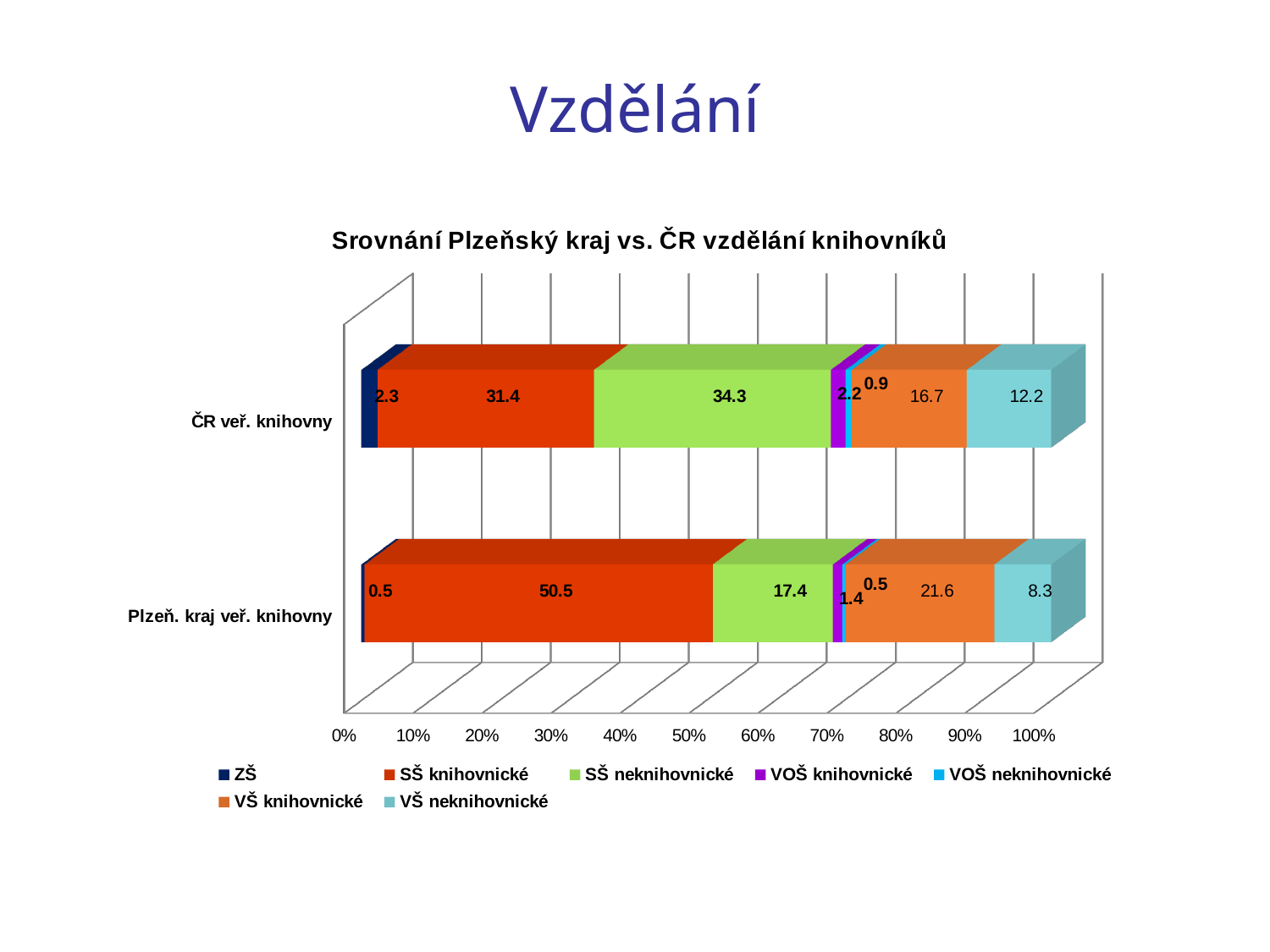
What is the value of VŠ knihovnické for Plzeň. kraj veř. knihovny? 21.6 How many categories (bars) are shown in the chart? 2 What is the difference between the SŠ knihovnické values for Plzeň. kraj veř. knihovny and ČR veř. knihovny? 19.1 What is the value of SŠ knihovnické for Plzeň. kraj veř. knihovny? 50.5 How many series does the legend list? 7 Which series has the largest value in the Plzeň. kraj veř. knihovny bar? SŠ knihovnické What is the value of ZŠ for ČR veř. knihovny? 2.3 Which has a larger VŠ knihovnické value, ČR veř. knihovny or Plzeň. kraj veř. knihovny? Plzeň. kraj veř. knihovny What kind of chart is shown on the slide? Stacked bar chart What is the value of VŠ neknihovnické for ČR veř. knihovny? 12.2 Which series has the largest value in the ČR veř. knihovny bar? SŠ neknihovnické What is the value of SŠ neknihovnické for ČR veř. knihovny? 34.3